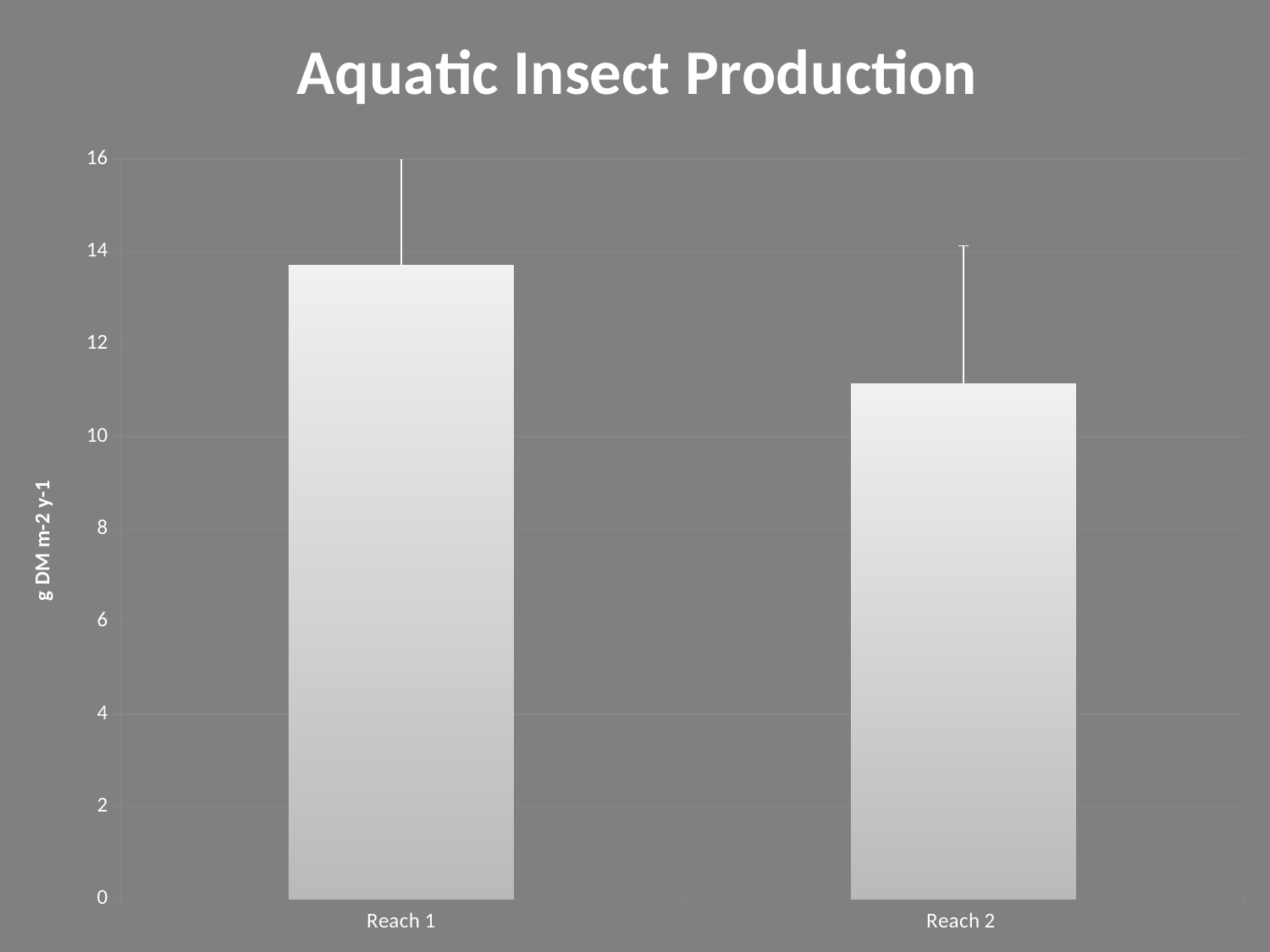
Which is larger, the value for Reach 1 or the value for Reach 2? Reach 1 What kind of chart is shown on the slide? bar chart What is the label on the y axis? g DM m-2 y-1 Is the value for Reach 1 greater or less than 12? greater Which category has the highest aquatic insect production? Reach 1 Is the value for Reach 2 greater or less than 12? less Do the values rise or fall from Reach 1 to Reach 2? fall Is the value for Reach 1 greater or less than 14? less Which category has the lowest aquatic insect production? Reach 2 What is the title of the chart? Aquatic Insect Production How many categories are plotted on the x axis? 2